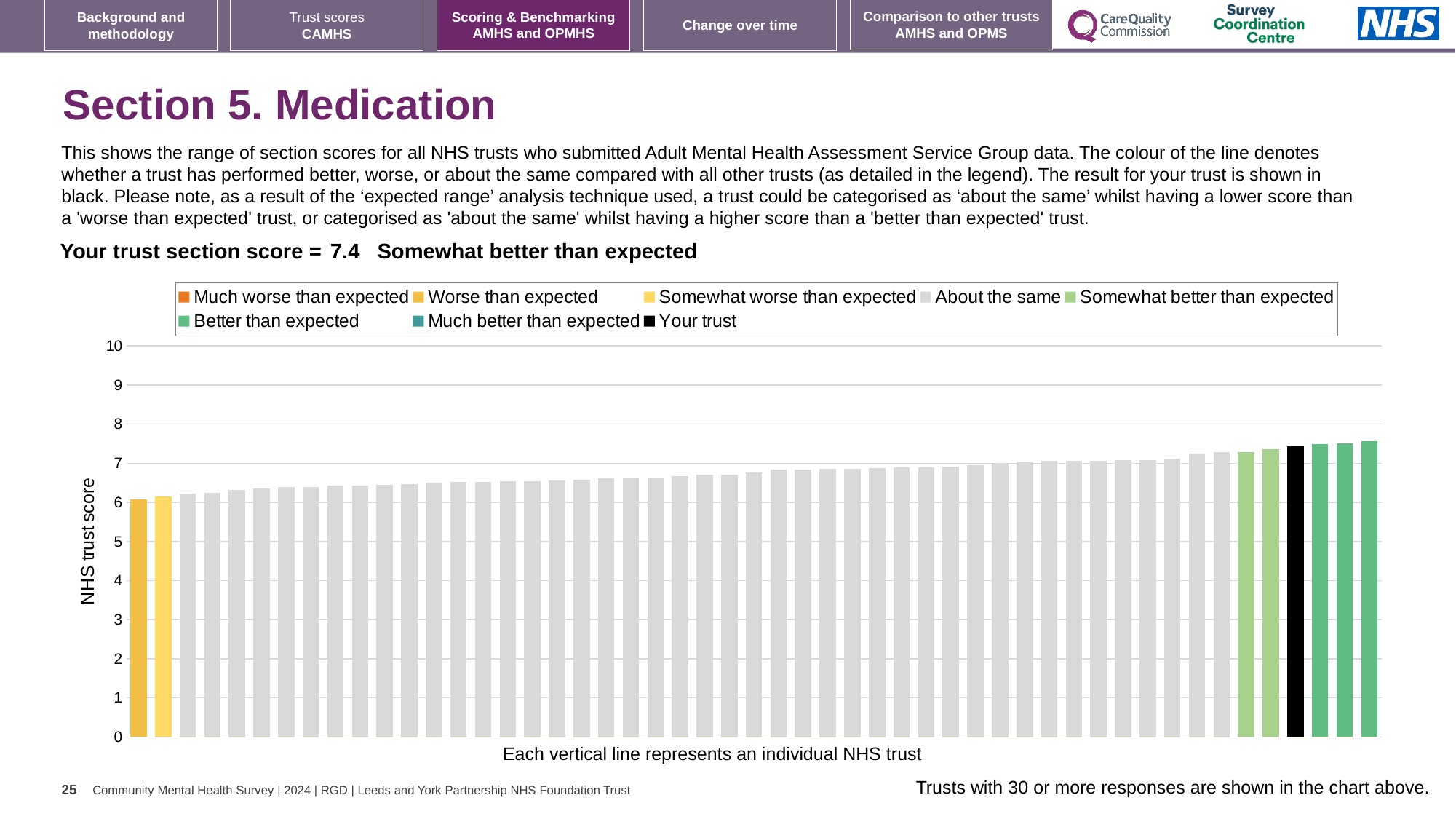
Is the value of the highest bar in the chart greater or less than 8? less How many bars are coloured as 'Somewhat better than expected' (light green)? 2 Do the bar values rise or fall from left to right across the chart? rise Is the value of the black 'Your trust' bar greater or less than 7? greater How many bars are coloured as 'Better than expected' (dark green)? 3 Which performance category is your trust placed in for Section 5. Medication? Somewhat better than expected What kind of chart is shown on the slide? bar chart What is the section score for your trust shown on the slide? 7.4 Is the value of the lowest bar in the chart greater or less than 5? greater What is the label on the vertical axis of the chart? NHS trust score Is the 'Your trust' bar higher or lower than the leftmost bar in the chart? higher How many entries does the chart legend list? 8